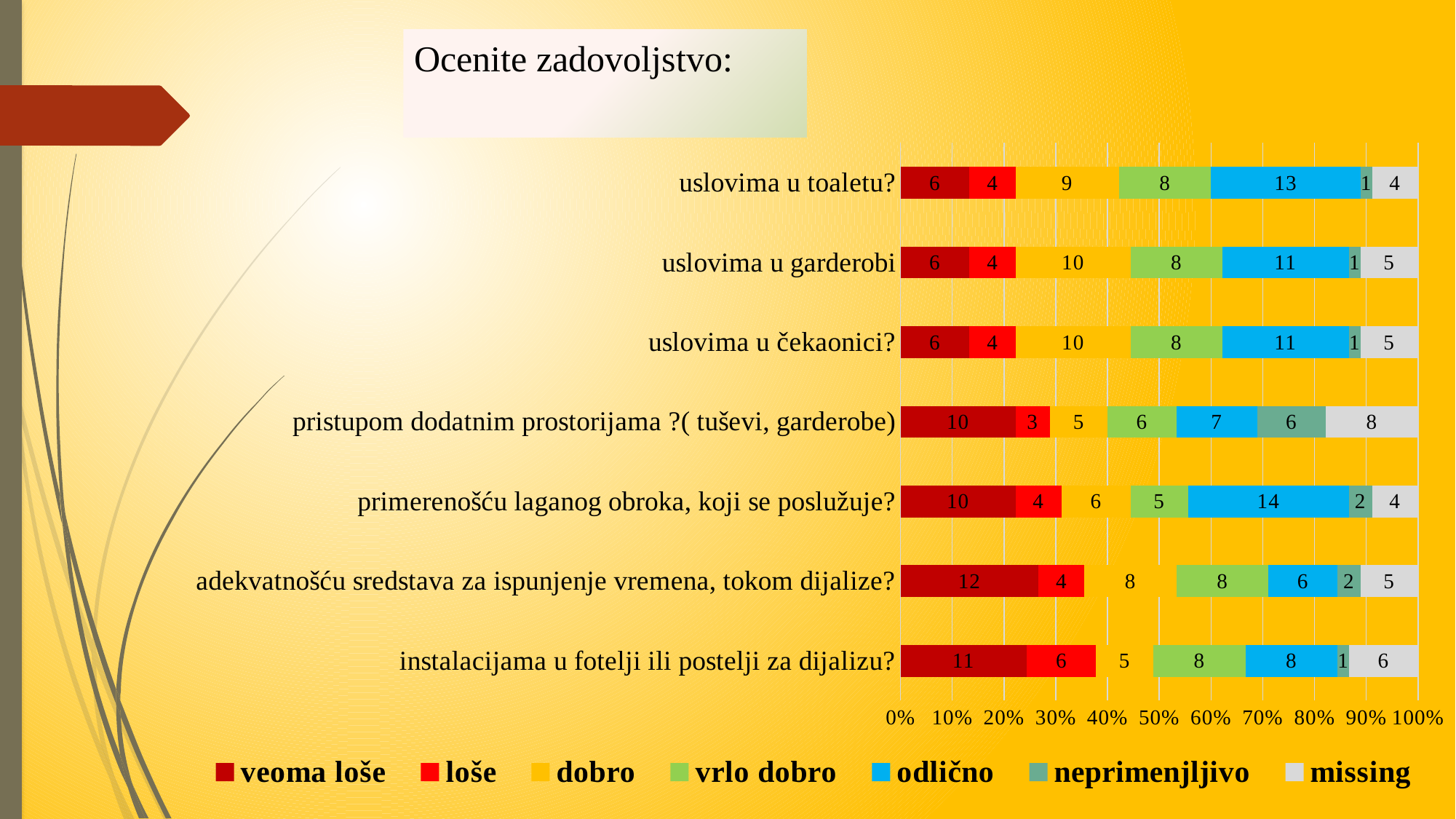
Which category has the highest 'odlično' value? primerenošću laganog obroka, koji se poslužuje? Which is larger: the 'veoma loše' value for 'instalacijama u fotelji ili postelji za dijalizu?' or for 'uslovima u čekaonici?'? instalacijama u fotelji ili postelji za dijalizu? How many categories are plotted on the chart? 7 What is the value of 'odlično' for 'uslovima u toaletu?'? 13 What is the value of 'missing' for 'pristupom dodatnim prostorijama ?( tuševi, garderobe)'? 8 Which category has the lowest 'loše' value? pristupom dodatnim prostorijama ?( tuševi, garderobe) What is the difference between the 'odlično' values for 'uslovima u toaletu?' and 'uslovima u garderobi'? 2 What is the value of 'veoma loše' for 'adekvatnošću sredstava za ispunjenje vremena, tokom dijalize?'? 12 How many series does the legend list? 7 What is the total of all segments in the bar for 'uslovima u toaletu?'? 45 What is the title of the chart? Ocenite zadovoljstvo: What type of chart is shown on the slide? stacked bar chart